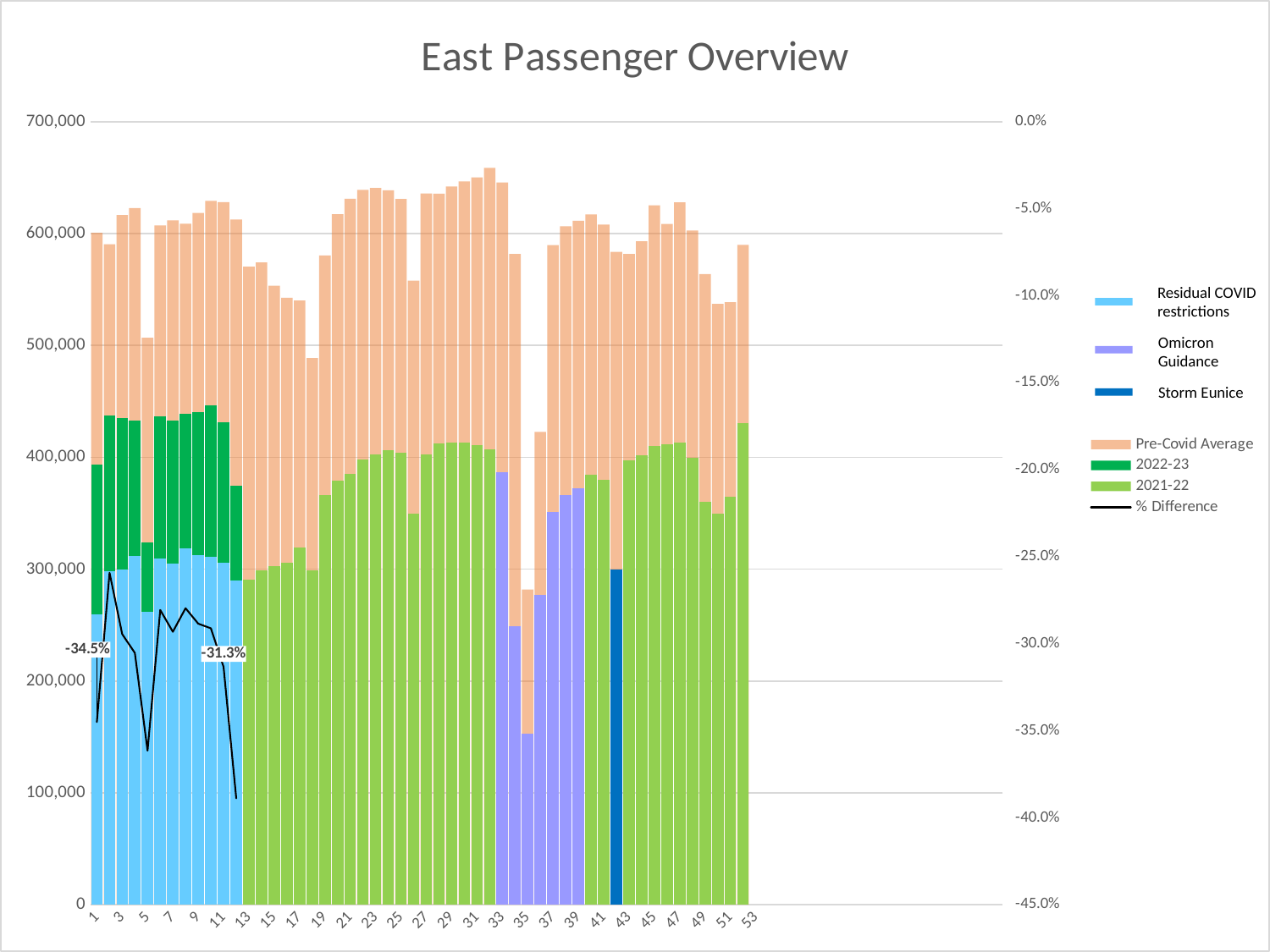
Which week has the lowest point on the % Difference line? Week 12 Which week has the shortest stacked bar overall? Week 35 What is the name of the series plotted as a black line? % Difference Is the total bar height for week 35 greater or less than 300,000? less What is the highest value shown on the left vertical axis? 700,000 Which week has the tallest stacked bar overall? Week 32 What is the data label shown at the left end of the % Difference line? -34.5% What are the two data labels printed on the % Difference line? -34.5% and -31.3% Is the total bar height for week 18 greater or less than 500,000? less Is the Storm Eunice bar (week 43) greater or less than 250,000? greater What kind of chart is this? A bar chart with a line (combination bar and line chart) What is the title of the chart? East Passenger Overview